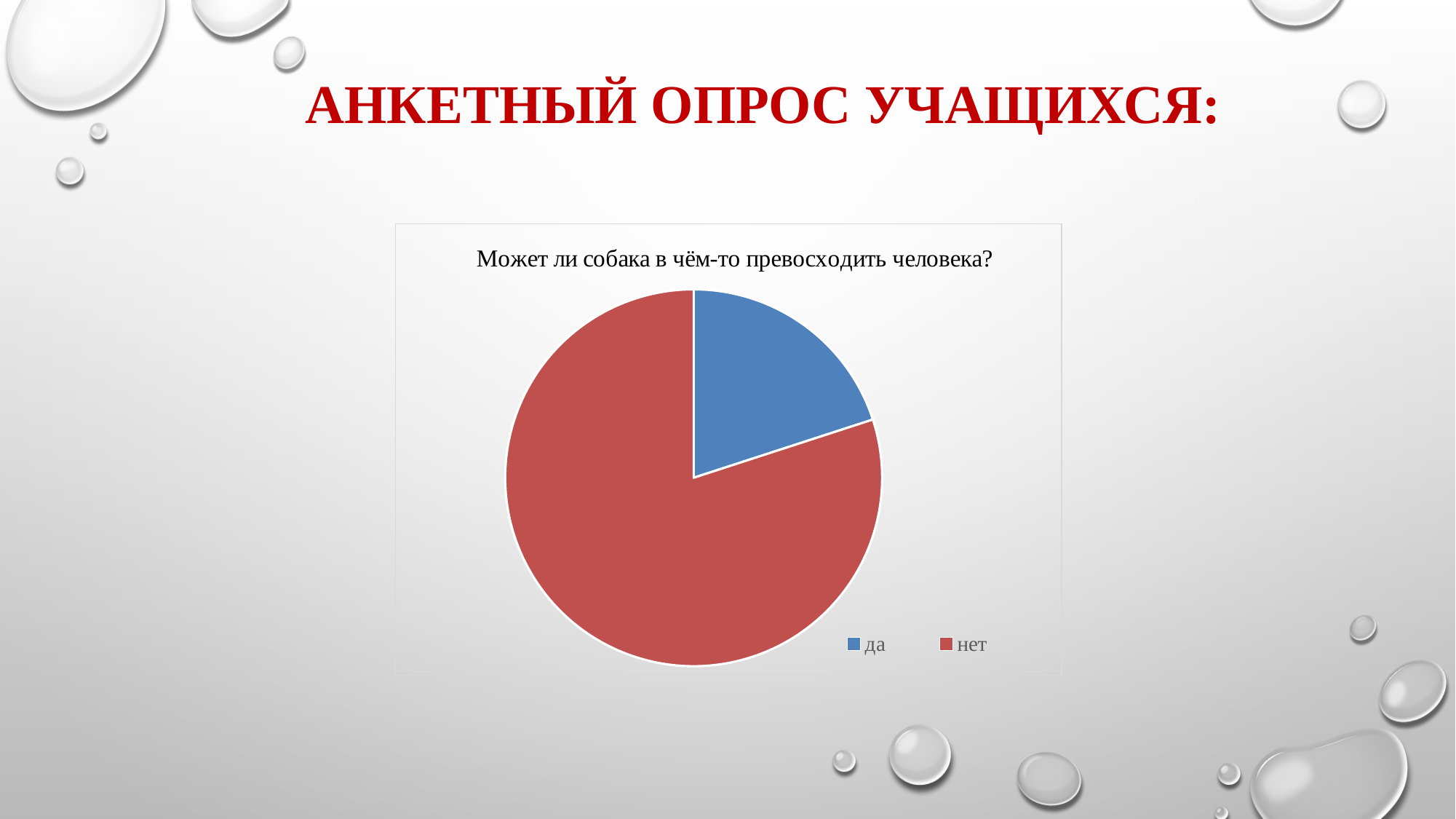
Which answer has the largest slice of the pie? нет What is the title of the chart? Может ли собака в чём-то превосходить человека? Which slice is larger, "да" or "нет"? нет What colour is the "да" slice? blue How many slices does the pie chart have? 2 Is the "нет" slice more or less than half of the pie? more What kind of chart is shown on the slide? pie chart Which answer has the smallest slice of the pie? да How many entries does the legend list? 2